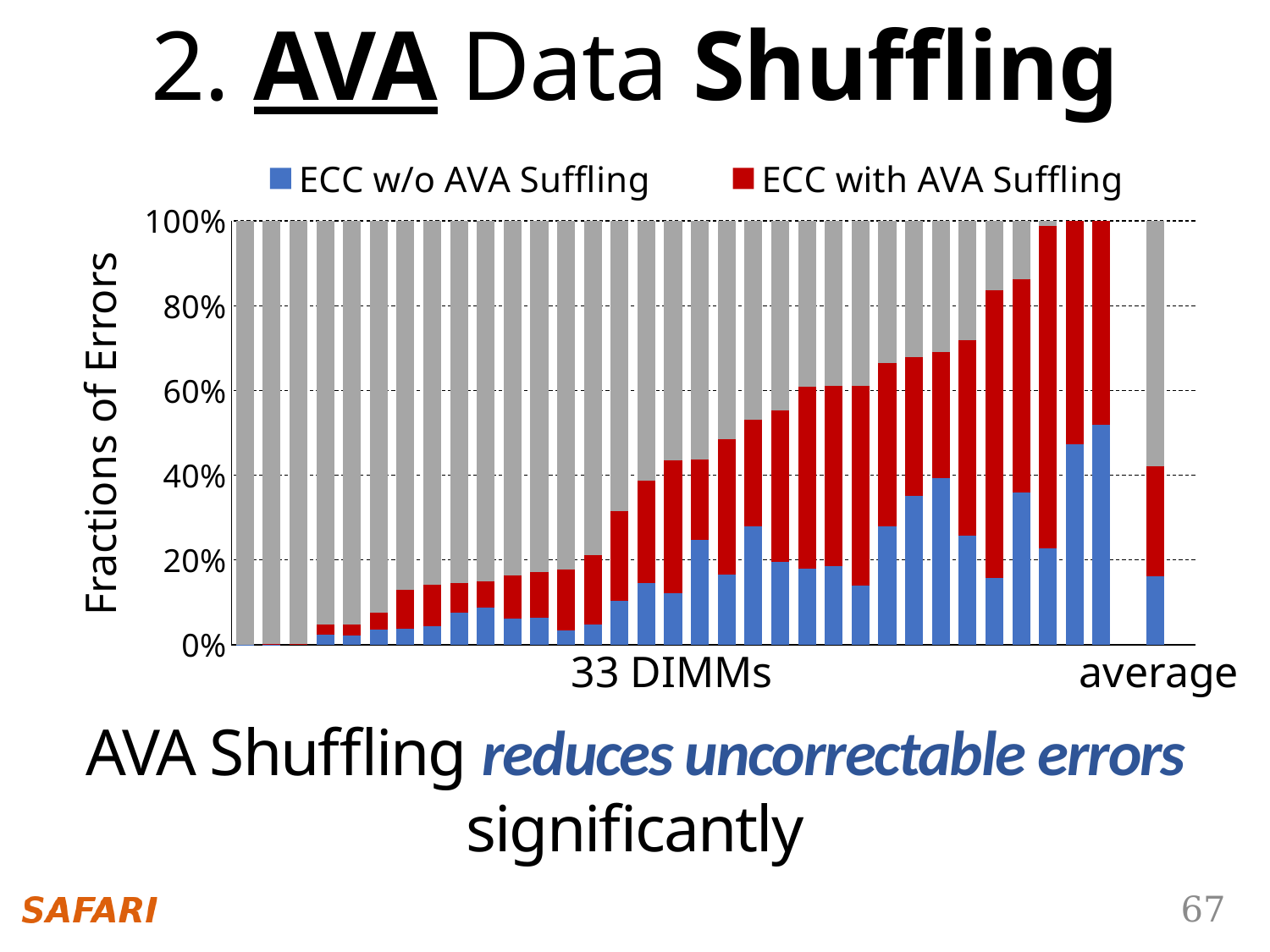
Do the stacked bar heights for the 33 DIMMs rise or fall from left to right along the x axis? rise Is the top of the ECC with AVA Suffling segment for the average bar greater or less than 60%? less How many series does the legend list? 2 Which DIMM bar has the highest ECC w/o AVA Suffling value: the leftmost DIMM or the rightmost DIMM? the rightmost DIMM What kind of chart is shown on the slide? stacked bar chart According to the x-axis label, how many DIMMs are plotted (excluding the average bar)? 33 Is the ECC w/o AVA Suffling value for the rightmost DIMM bar greater or less than 40%? greater What is the label on the vertical axis? Fractions of Errors Is the ECC w/o AVA Suffling value for the average bar greater or less than 20%? less What are the two series named in the legend? ECC w/o AVA Suffling and ECC with AVA Suffling What is the highest value shown on the vertical axis? 100%